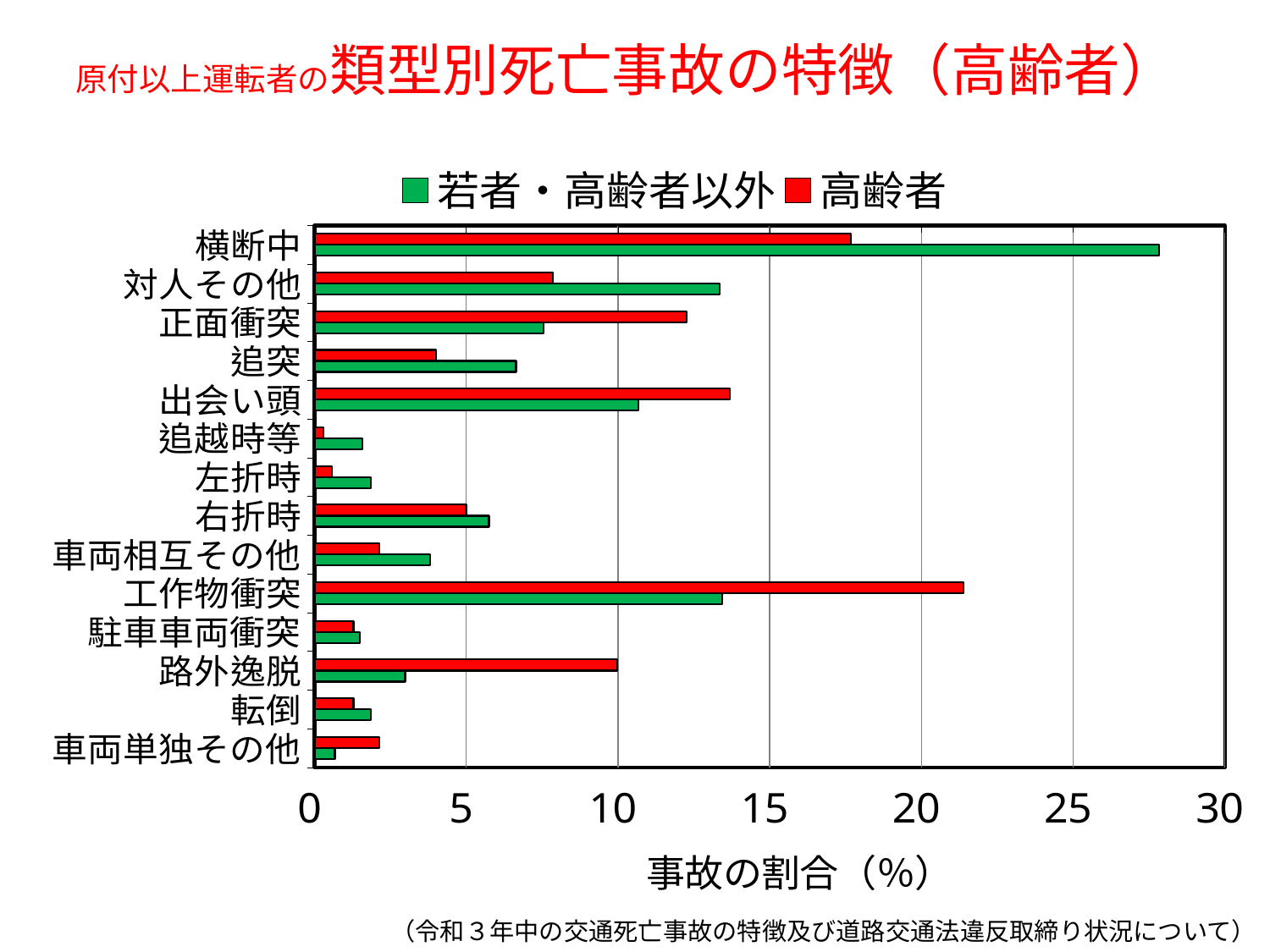
What kind of chart is shown on the slide? bar chart Which category has the lowest value for the 若者・高齢者以外 series? 車両単独その他 Is the 高齢者 value for 出会い頭 greater or less than 10? greater Which category has the highest value for the 若者・高齢者以外 series? 横断中 Is the 高齢者 value for 工作物衝突 greater or less than 20? greater Is the 若者・高齢者以外 value for 横断中 greater or less than 25? greater How many accident-type categories are plotted on the chart? 14 Which category has the lowest value for the 高齢者 series? 追越時等 How many series does the legend list? 2 What is the label of the x axis? 事故の割合（%） For 路外逸脱, which series has the larger value, 若者・高齢者以外 or 高齢者? 高齢者 Which category has the highest value for the 高齢者 series? 工作物衝突